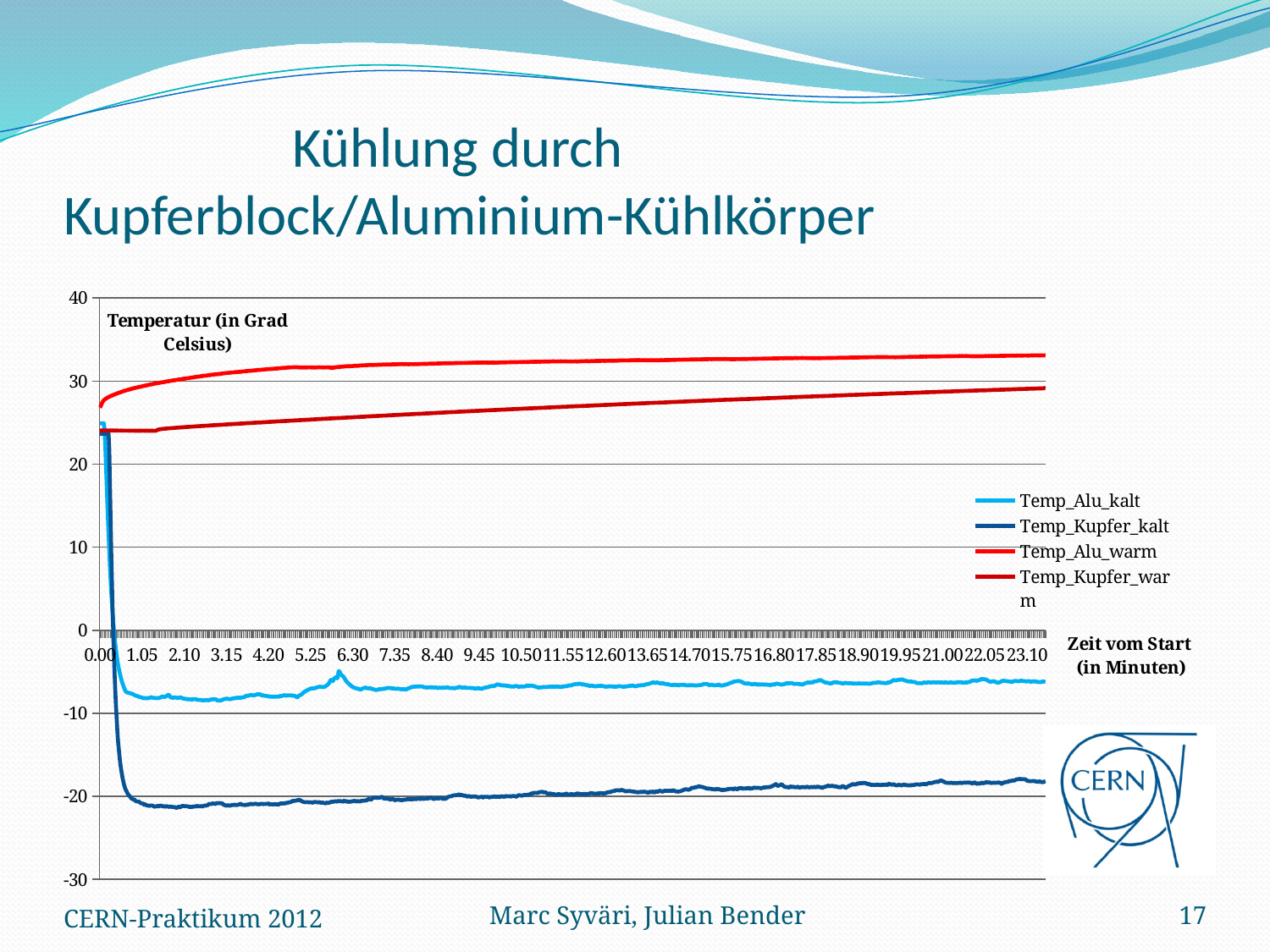
Which series are listed in the chart's legend? Temp_Alu_kalt, Temp_Kupfer_kalt, Temp_Alu_warm, Temp_Kupfer_warm Does the Temp_Alu_warm series rise or fall over time along the x axis? rise How many series does the legend of the chart list? 4 Is the value of Temp_Alu_warm at the end of the measurement (23.10 minutes) greater or less than 30? greater Which series has the lowest values in the chart? Temp_Kupfer_kalt What kind of chart is shown on the slide? line chart Is the value of Temp_Kupfer_warm at the end of the measurement (23.10 minutes) greater or less than 20? greater At the end of the measurement, which series has the higher value: Temp_Alu_warm or Temp_Kupfer_warm? Temp_Alu_warm Does the Temp_Kupfer_warm series rise or fall over time along the x axis? rise What is the label of the vertical axis of the chart? Temperatur (in Grad Celsius) Is the value of Temp_Alu_kalt at the end of the measurement (23.10 minutes) greater or less than 0? less